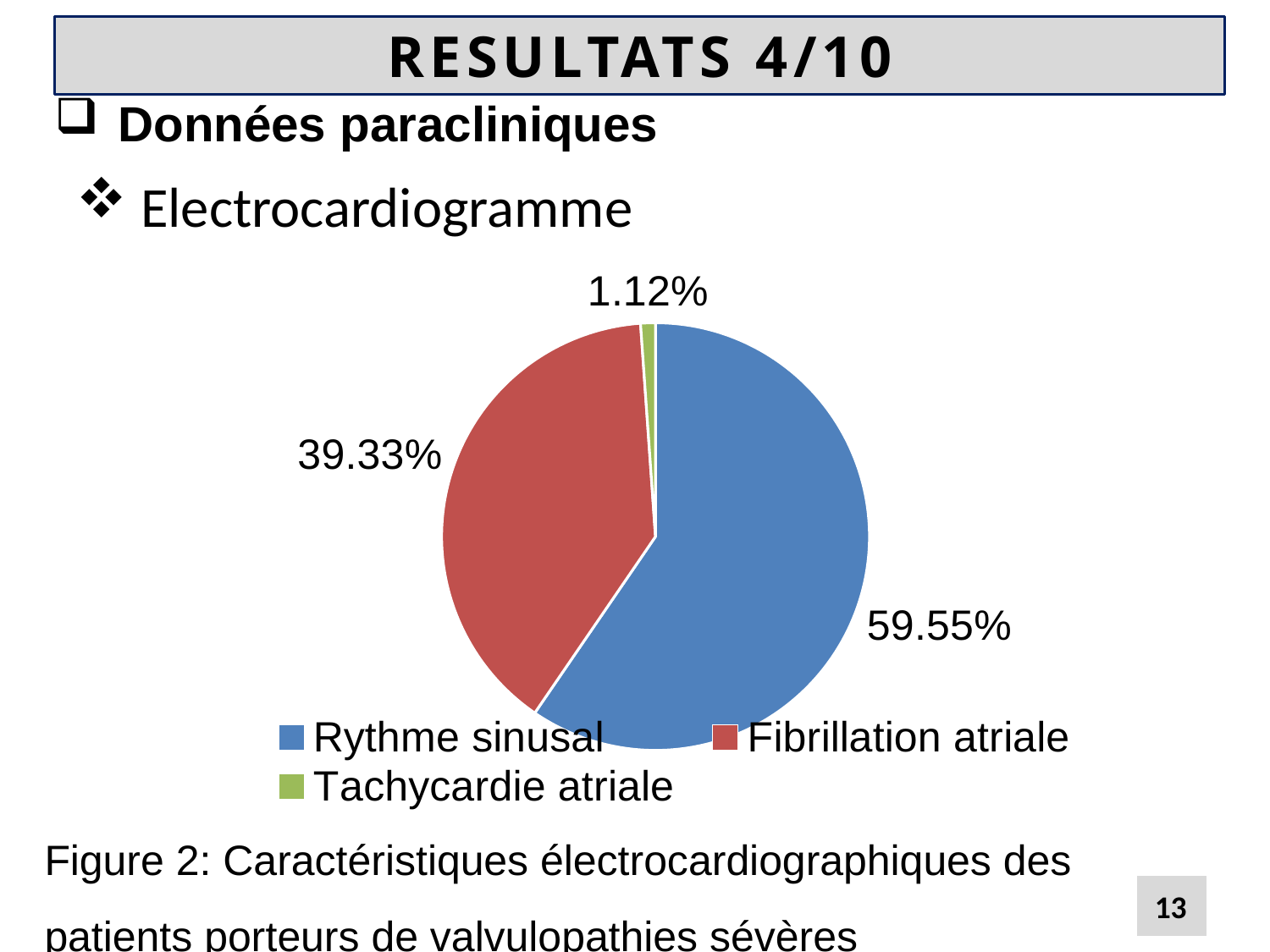
What is the difference between the shares of Rythme sinusal and Fibrillation atriale? 20.22% What is the figure caption number given below the chart? Figure 2 Which is larger, the share for Fibrillation atriale or the share for Tachycardie atriale? Fibrillation atriale What kind of chart is shown on the slide? pie chart How many entries does the legend list? 3 What is the share for Tachycardie atriale? 1.12% What is the share for Fibrillation atriale? 39.33% How many categories does the pie chart show? 3 Which category has the largest slice of the pie? Rythme sinusal What is the share for Rythme sinusal? 59.55% What colour is the slice for Fibrillation atriale? red Which category has the smallest slice of the pie? Tachycardie atriale